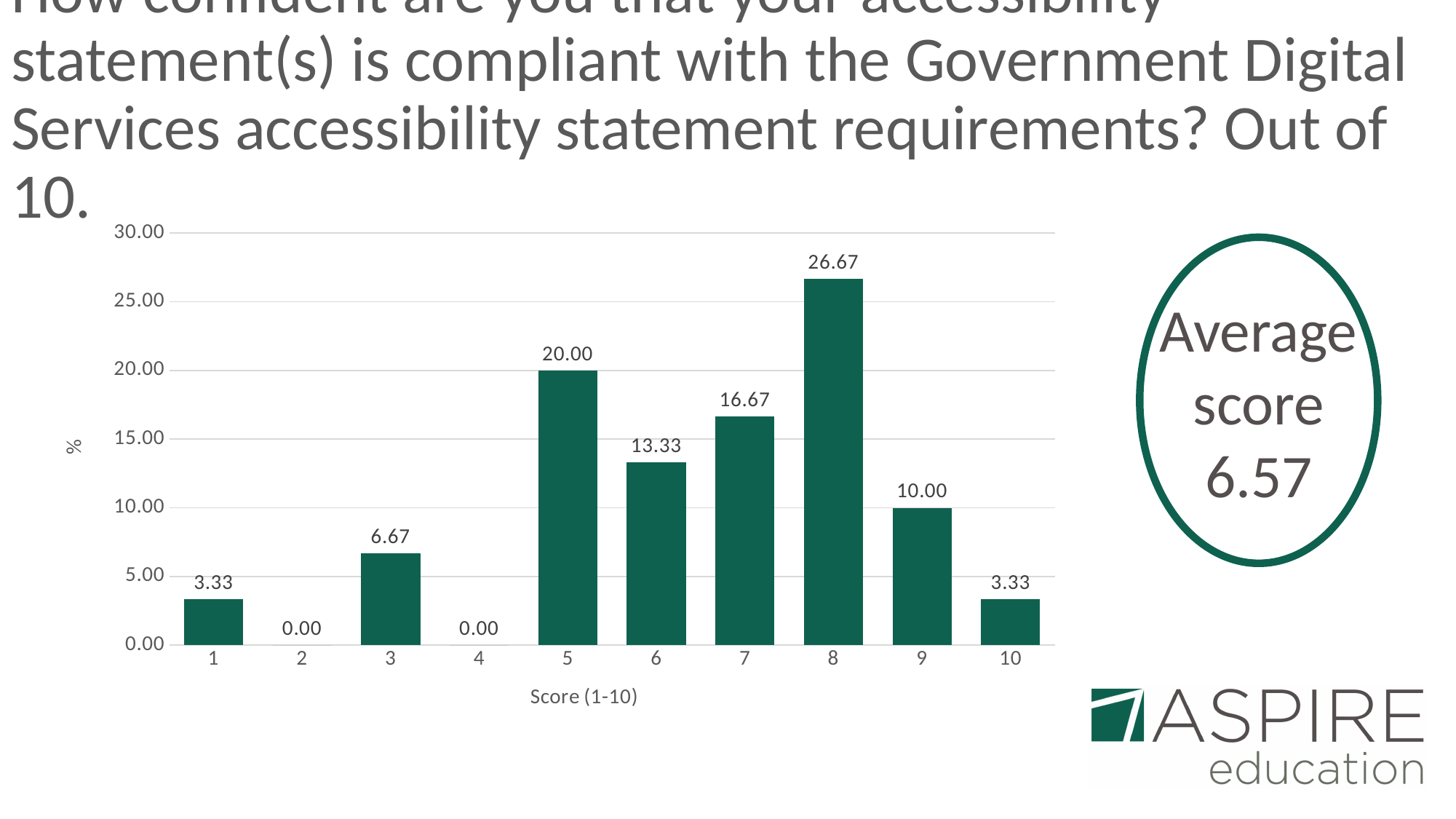
What is the value for score 5? 20.00 How many score categories are shown on the x axis? 10 What is the value for score 3? 6.67 What is the difference between the values for score 8 and score 7? 10.00 What is the value for score 8? 26.67 Is the value for score 7 greater or less than 15.00? greater What is the x-axis label of the chart? Score (1-10) Which scores have a value of 0.00? 2 and 4 Which score has the highest value? 8 Which has a larger value, score 6 or score 9? Score 6 What kind of chart is shown on the slide? Bar chart What average score is shown in the circle next to the chart? 6.57